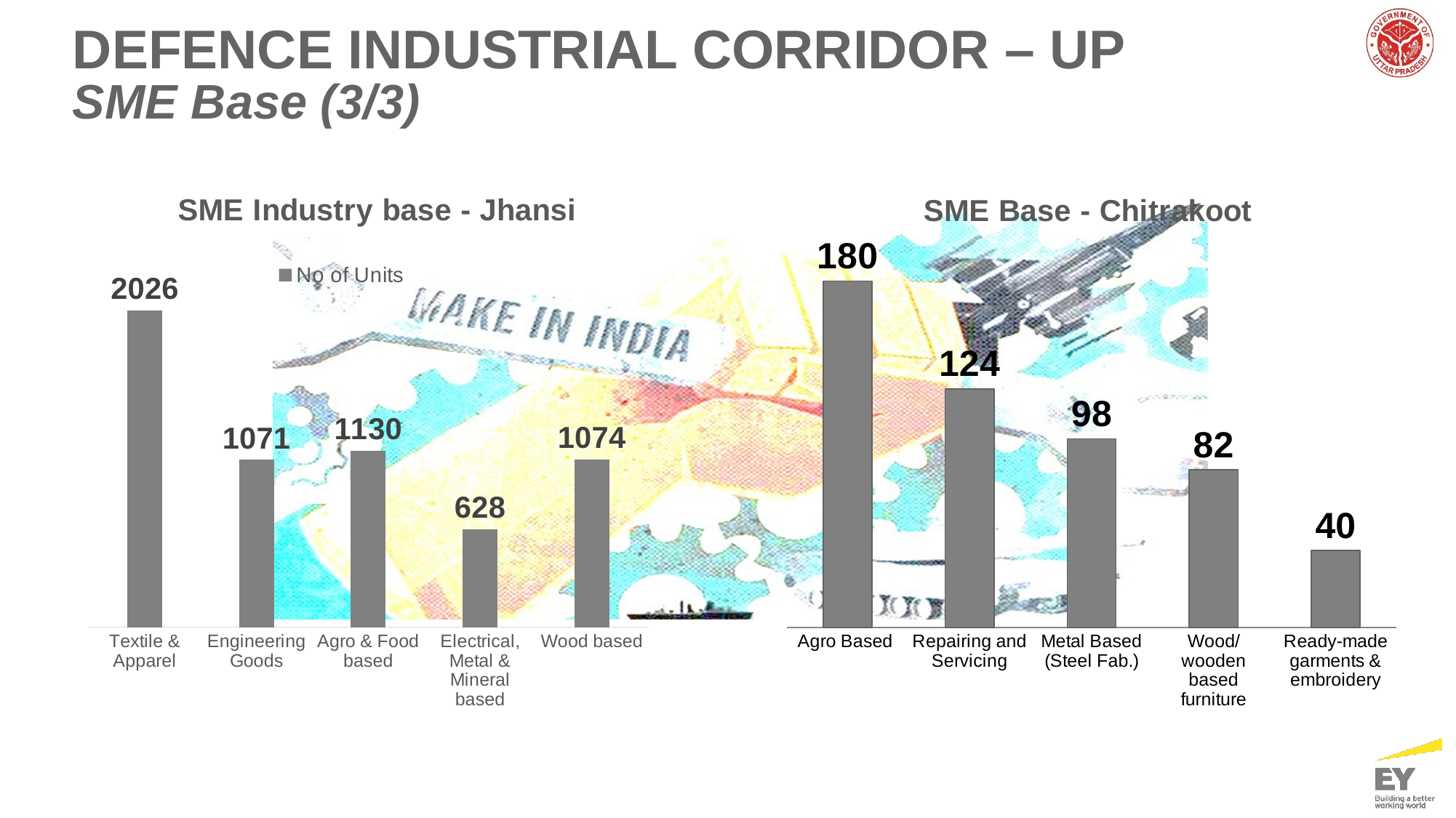
In the 'SME Base - Chitrakoot' chart, what is the value for Repairing and Servicing? 124 In the 'SME Industry base - Jhansi' chart, what is the number of units for Textile & Apparel? 2026 What type of chart is the 'SME Base - Chitrakoot' chart? Bar chart In the 'SME Industry base - Jhansi' chart, how many categories are shown? 5 In the 'SME Industry base - Jhansi' chart, which category has the highest number of units? Textile & Apparel In the 'SME Industry base - Jhansi' chart, which category has the lowest number of units? Electrical, Metal & Mineral based In the 'SME Industry base - Jhansi' chart, what is the difference between Textile & Apparel and Engineering Goods? 955 In the 'SME Industry base - Jhansi' chart, what series name does the legend show? No of Units In the 'SME Base - Chitrakoot' chart, which category has the highest value? Agro Based In the 'SME Industry base - Jhansi' chart, what is the value for Electrical, Metal & Mineral based? 628 In the 'SME Base - Chitrakoot' chart, what is the difference between Metal Based (Steel Fab.) and Wood/wooden based furniture? 16 In the 'SME Base - Chitrakoot' chart, what is the value for Ready-made garments & embroidery? 40